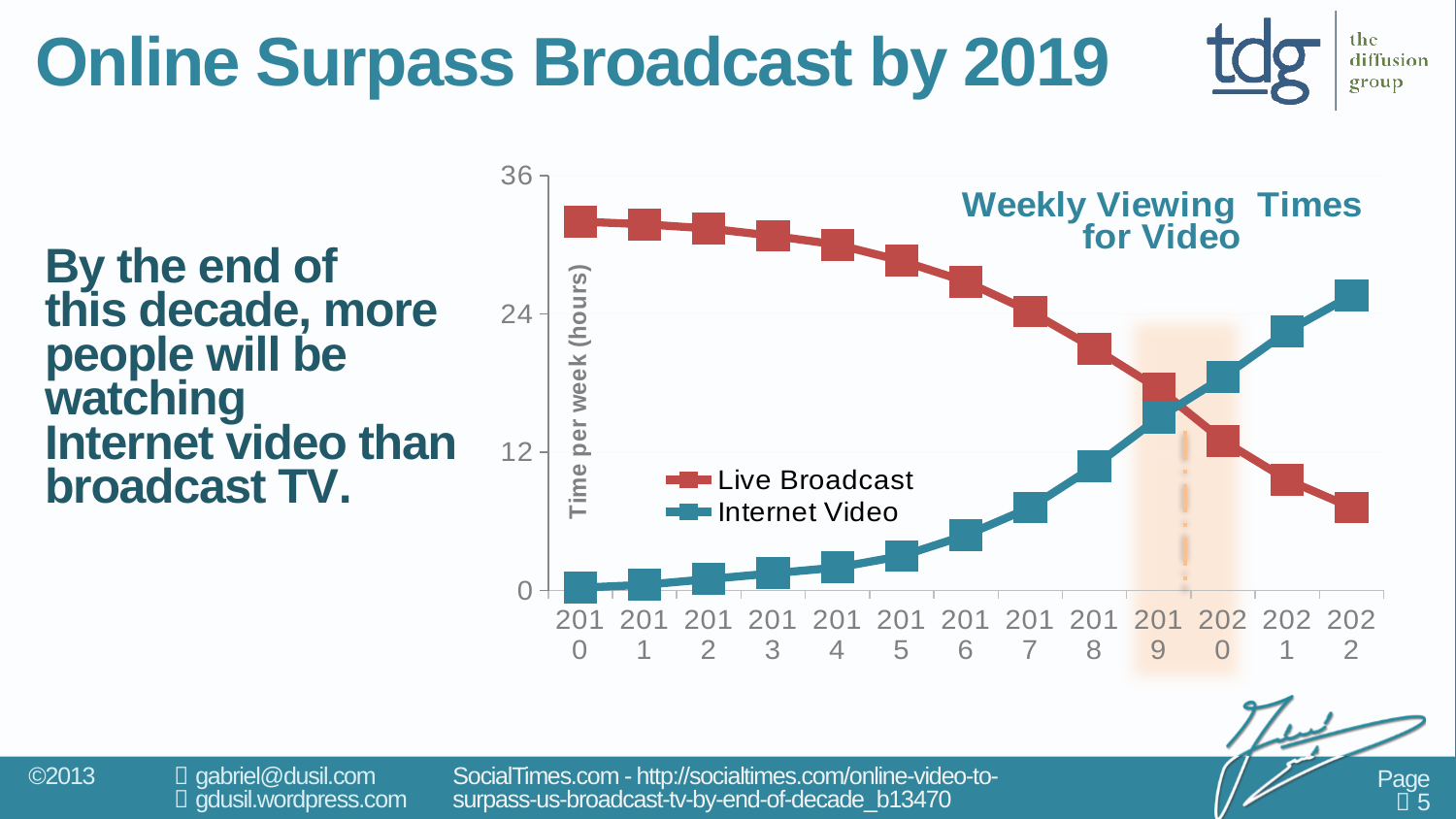
How many years are plotted along the x axis of the chart? 13 In 2022, which series has the larger value, Live Broadcast or Internet Video? Internet Video What is the label on the chart's vertical axis? Time per week (hours) How many series does the chart's legend list? 2 In which year is the Internet Video value lowest? 2010 Is the Live Broadcast value for 2022 greater or less than 12? less Is the Live Broadcast value for 2010 greater or less than 24? greater Does the Internet Video series rise or fall from 2010 to 2022? rise Does the Live Broadcast series rise or fall from 2010 to 2022? fall Is the Internet Video value for 2022 greater or less than 24? greater What kind of chart is shown on the slide? line chart In which year is the Live Broadcast value highest? 2010